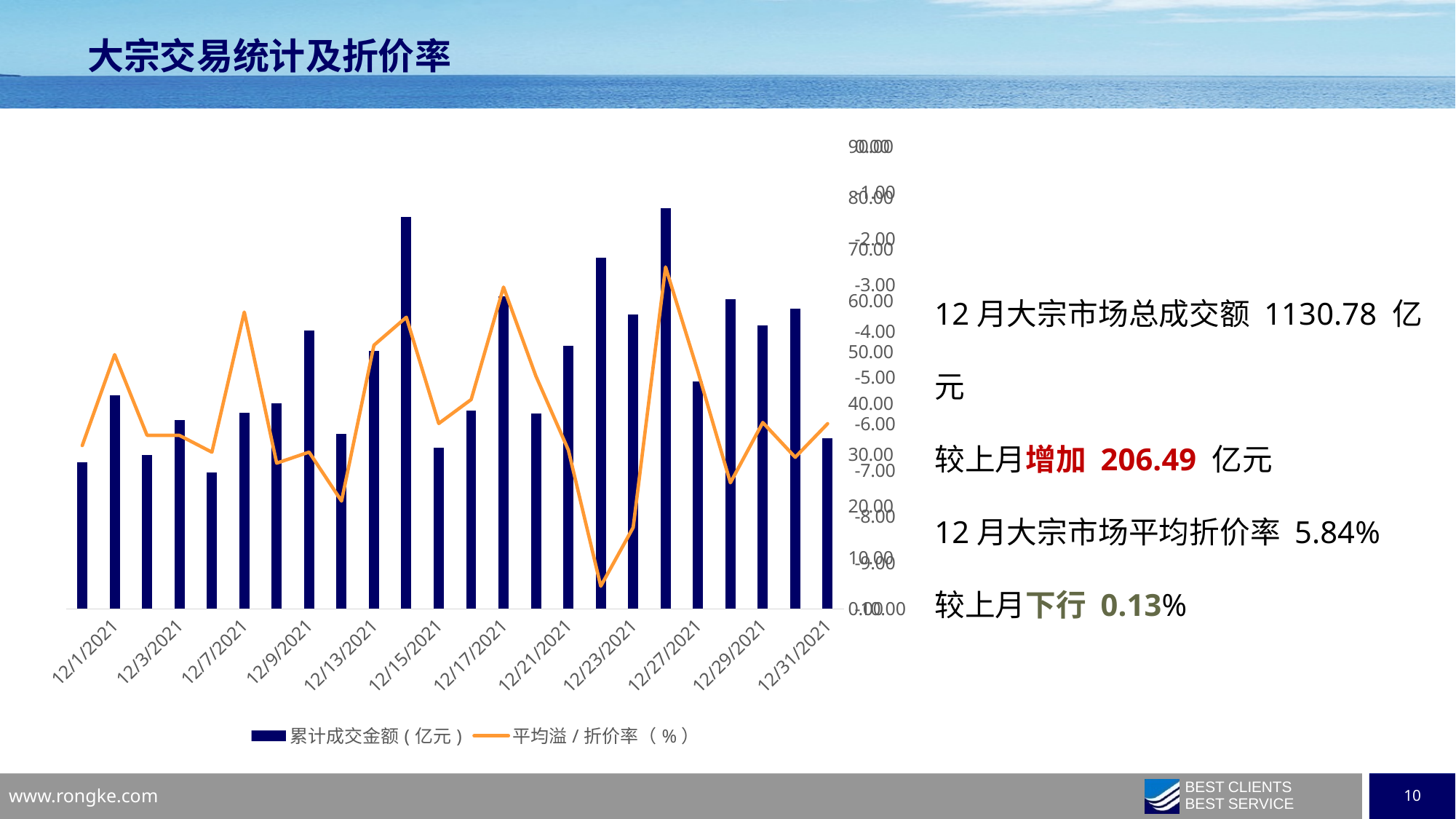
Is the 累计成交金额 bar for 12/7/2021 greater or less than 30? greater How many bars are plotted in the chart? 24 Which has the larger 累计成交金额 bar, 12/27/2021 or 12/7/2021? 12/27/2021 Is the 平均溢/折价率 value for 12/23/2021 greater or less than -9.00? greater Which date has the higher 平均溢/折价率 value, 12/23/2021 or 12/27/2021? 12/27/2021 How many series does the chart legend list? 2 What kind of chart is shown on the slide? A combination bar and line chart Is the 累计成交金额 bar for 12/27/2021 greater or less than 70? less What is the first date label on the x axis of the chart? 12/1/2021 What are the two series named in the chart legend? 累计成交金额（亿元） and 平均溢/折价率（%）